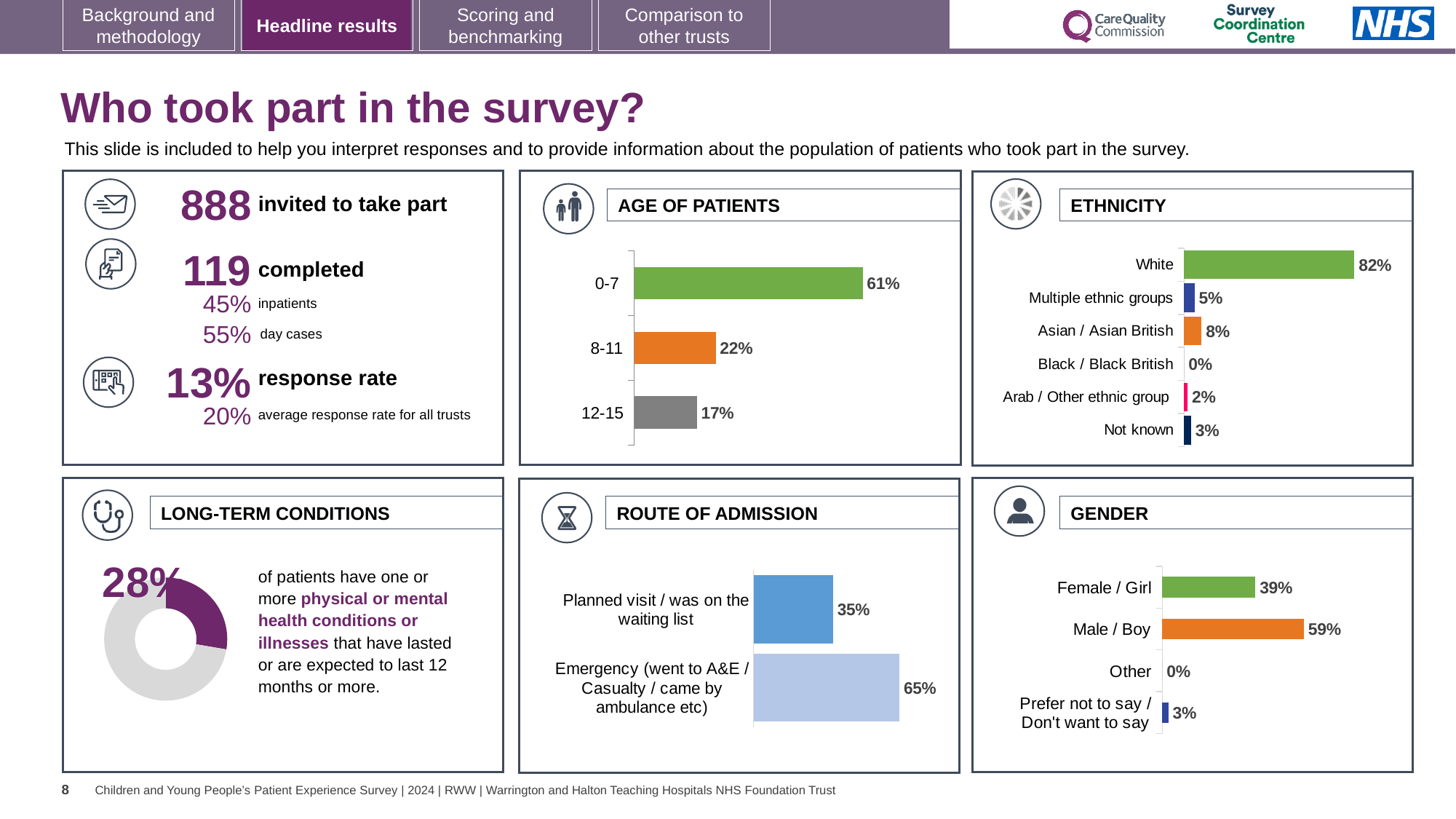
In the GENDER chart, what percentage of patients were Male / Boy? 59% In the ROUTE OF ADMISSION chart, which is larger: Planned visit / was on the waiting list or Emergency? Emergency How many ethnicity categories are shown in the ETHNICITY chart? 6 In the AGE OF PATIENTS chart, which age group has the lowest percentage? 12-15 In the AGE OF PATIENTS chart, what is the difference between the 0-7 and 8-11 percentages? 39% In the ETHNICITY chart, what percentage of patients were Asian / Asian British? 8% In the ROUTE OF ADMISSION chart, what percentage of patients came via Emergency (went to A&E / Casualty / came by ambulance etc)? 65% In the ETHNICITY chart, which category has the highest percentage? White In the LONG-TERM CONDITIONS chart, what share of patients have one or more long-term conditions? 28% In the AGE OF PATIENTS chart, what percentage of patients were aged 0-7? 61% What kind of chart is used in the LONG-TERM CONDITIONS panel? Donut chart In the GENDER chart, what is the difference between Male / Boy and Female / Girl? 20%